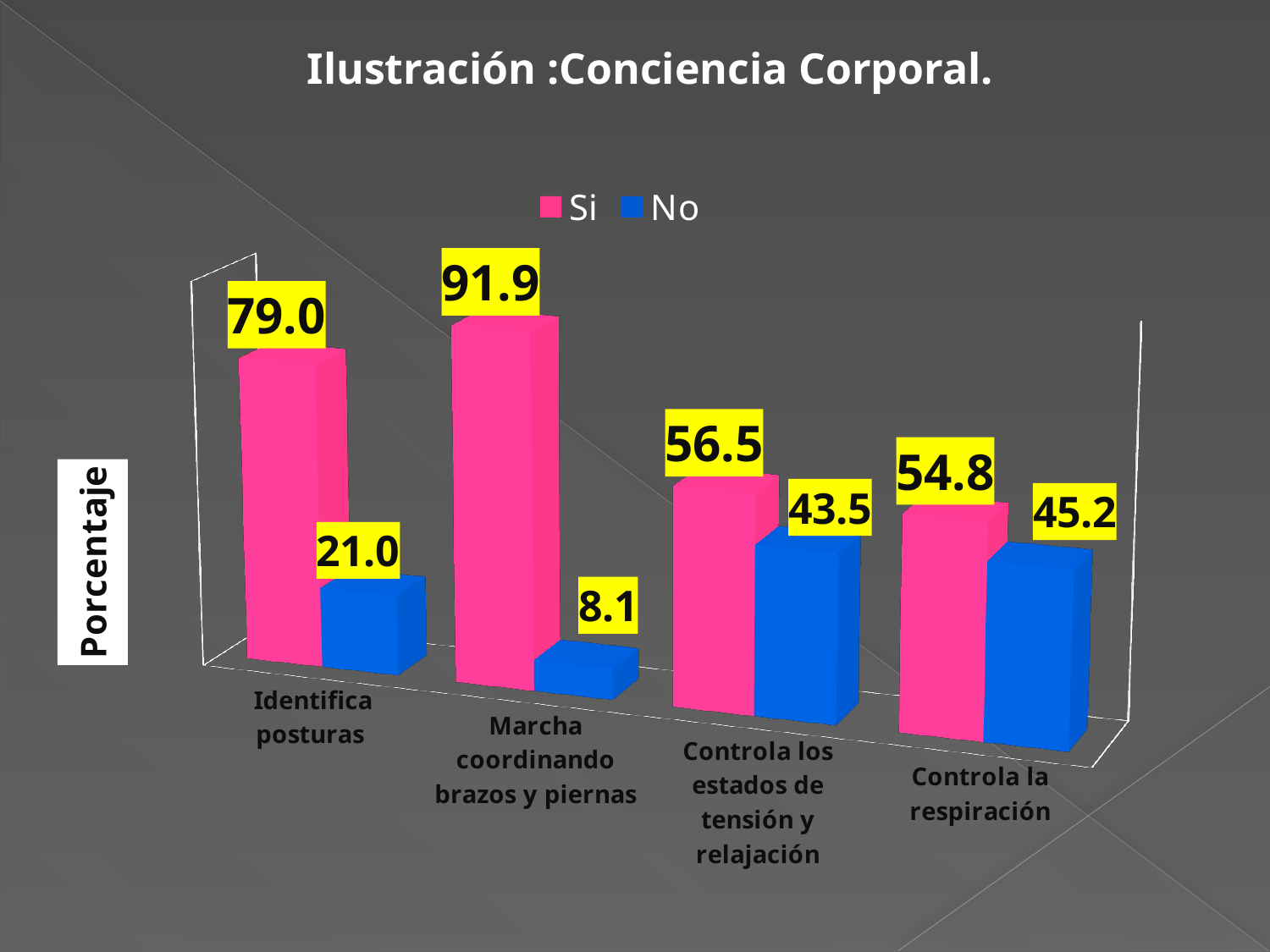
What is the difference between the 'Si' and 'No' values for 'Controla los estados de tensión y relajación'? 13.0 Which category has the lowest 'No' value? Marcha coordinando brazos y piernas What is the 'Si' value for 'Marcha coordinando brazos y piernas'? 91.9 What kind of chart is shown on the slide? Bar chart How many categories are shown on the x axis? 4 What is the 'No' value for 'Controla la respiración'? 45.2 What is the title of the chart? Ilustración :Conciencia Corporal. Which category has the highest 'Si' value? Marcha coordinando brazos y piernas How many series does the legend list? 2 Which is larger for 'Controla la respiración', the 'Si' value or the 'No' value? Si What is the label of the vertical axis? Porcentaje What is the 'No' value for 'Identifica posturas'? 21.0